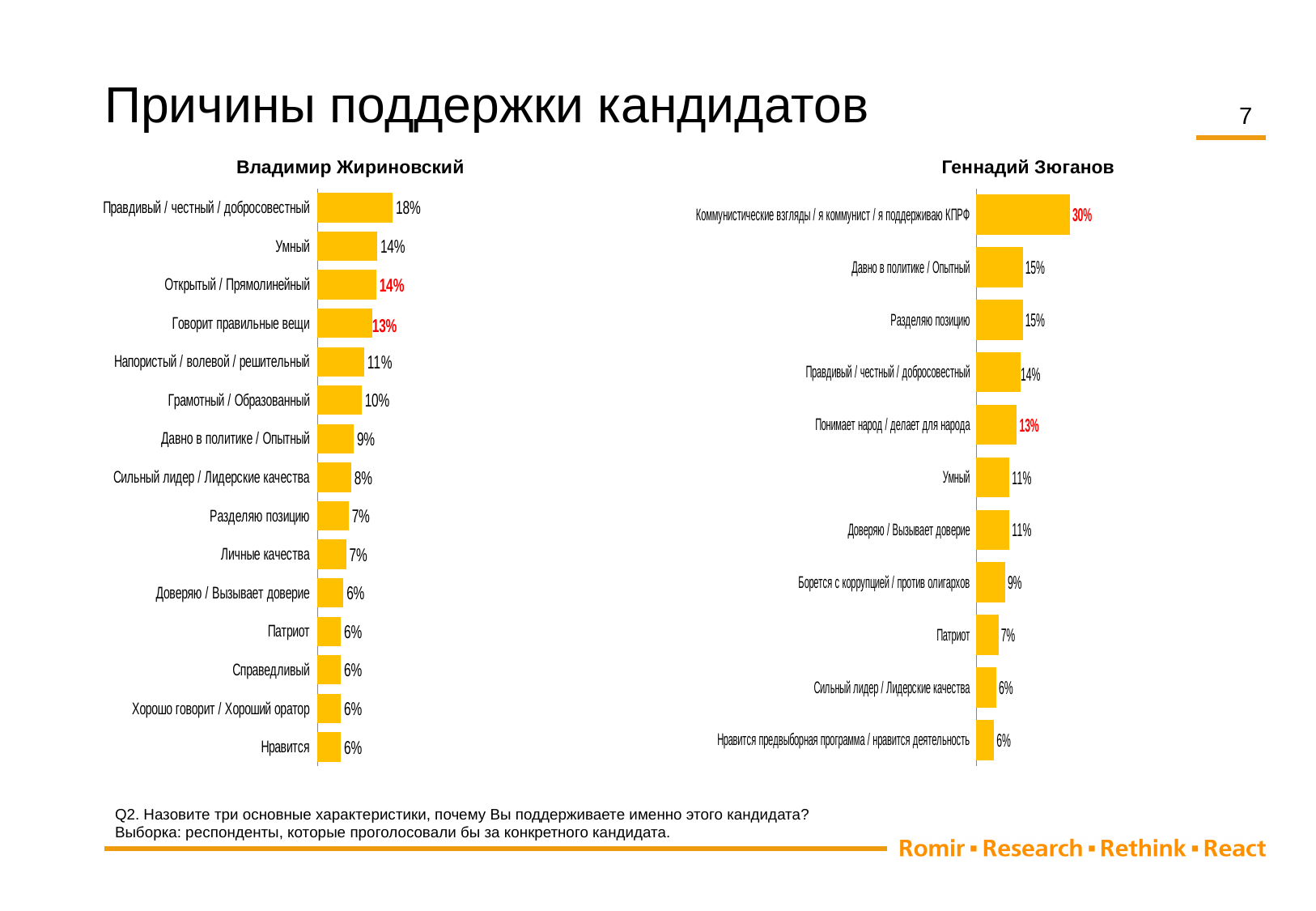
In the chart titled "Геннадий Зюганов", which is larger: the value for "Борется с коррупцией / против олигархов" or the value for "Патриот"? Борется с коррупцией / против олигархов In the chart titled "Владимир Жириновский", what is the value for "Давно в политике / Опытный"? 9% In the chart titled "Владимир Жириновский", what is the difference between the values for "Правдивый / честный / добросовестный" and "Умный"? 4% In the chart titled "Геннадий Зюганов", what is the difference between the values for "Коммунистические взгляды / я коммунист / я поддерживаю КПРФ" and "Давно в политике / Опытный"? 15% How many categories are shown in the chart titled "Владимир Жириновский"? 15 In the chart titled "Геннадий Зюганов", which category has the highest value? Коммунистические взгляды / я коммунист / я поддерживаю КПРФ How many categories are shown in the chart titled "Геннадий Зюганов"? 11 What kind of chart is the chart titled "Геннадий Зюганов"? Bar chart In the chart titled "Геннадий Зюганов", what is the value for "Коммунистические взгляды / я коммунист / я поддерживаю КПРФ"? 30% In the chart titled "Геннадий Зюганов", what is the value for "Понимает народ / делает для народа"? 13% In the chart titled "Владимир Жириновский", which category has the highest value? Правдивый / честный / добросовестный In the chart titled "Владимир Жириновский", what is the value for "Правдивый / честный / добросовестный"? 18%